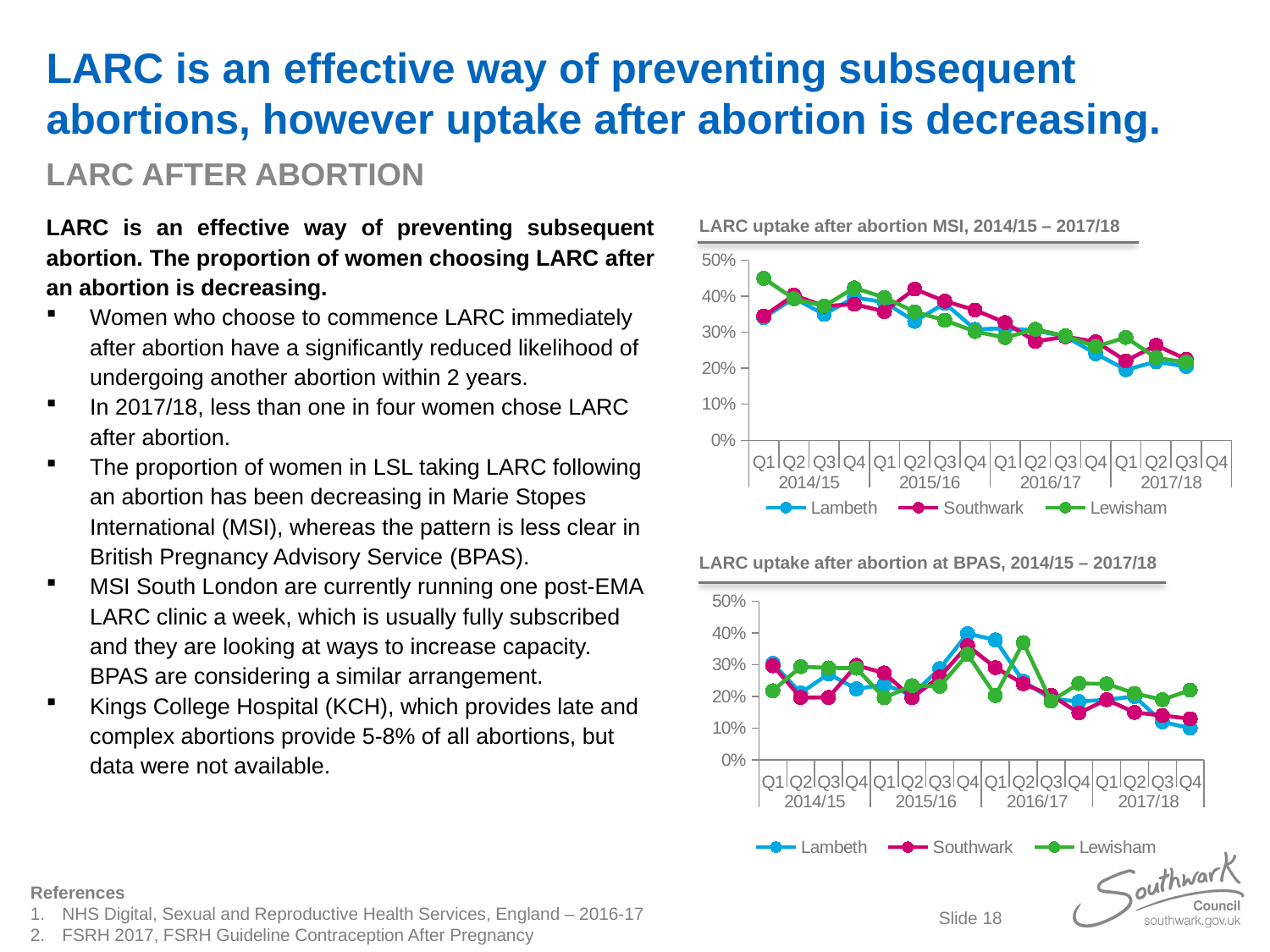
What kind of chart is 'LARC uptake after abortion MSI, 2014/15 – 2017/18'? line chart In the 'LARC uptake after abortion MSI, 2014/15 – 2017/18' chart, is the value for Lewisham in Q1 2014/15 greater or less than 40%? greater In the 'LARC uptake after abortion at BPAS, 2014/15 – 2017/18' chart, is the value for Lambeth in Q4 2015/16 greater or less than 30%? greater In the 'LARC uptake after abortion at BPAS, 2014/15 – 2017/18' chart, is the value for Southwark in Q4 2017/18 greater or less than 20%? less In the 'LARC uptake after abortion MSI, 2014/15 – 2017/18' chart, which series is shown in green? Lewisham In the 'LARC uptake after abortion MSI, 2014/15 – 2017/18' chart, do the values generally rise or fall from Q1 2014/15 to Q4 2017/18? fall How many series does the legend of the 'LARC uptake after abortion at BPAS, 2014/15 – 2017/18' chart list? 3 In the 'LARC uptake after abortion MSI, 2014/15 – 2017/18' chart, how many quarters are plotted along the x axis? 16 What kind of chart is 'LARC uptake after abortion at BPAS, 2014/15 – 2017/18'? line chart How many series does the legend of the 'LARC uptake after abortion MSI, 2014/15 – 2017/18' chart list? 3